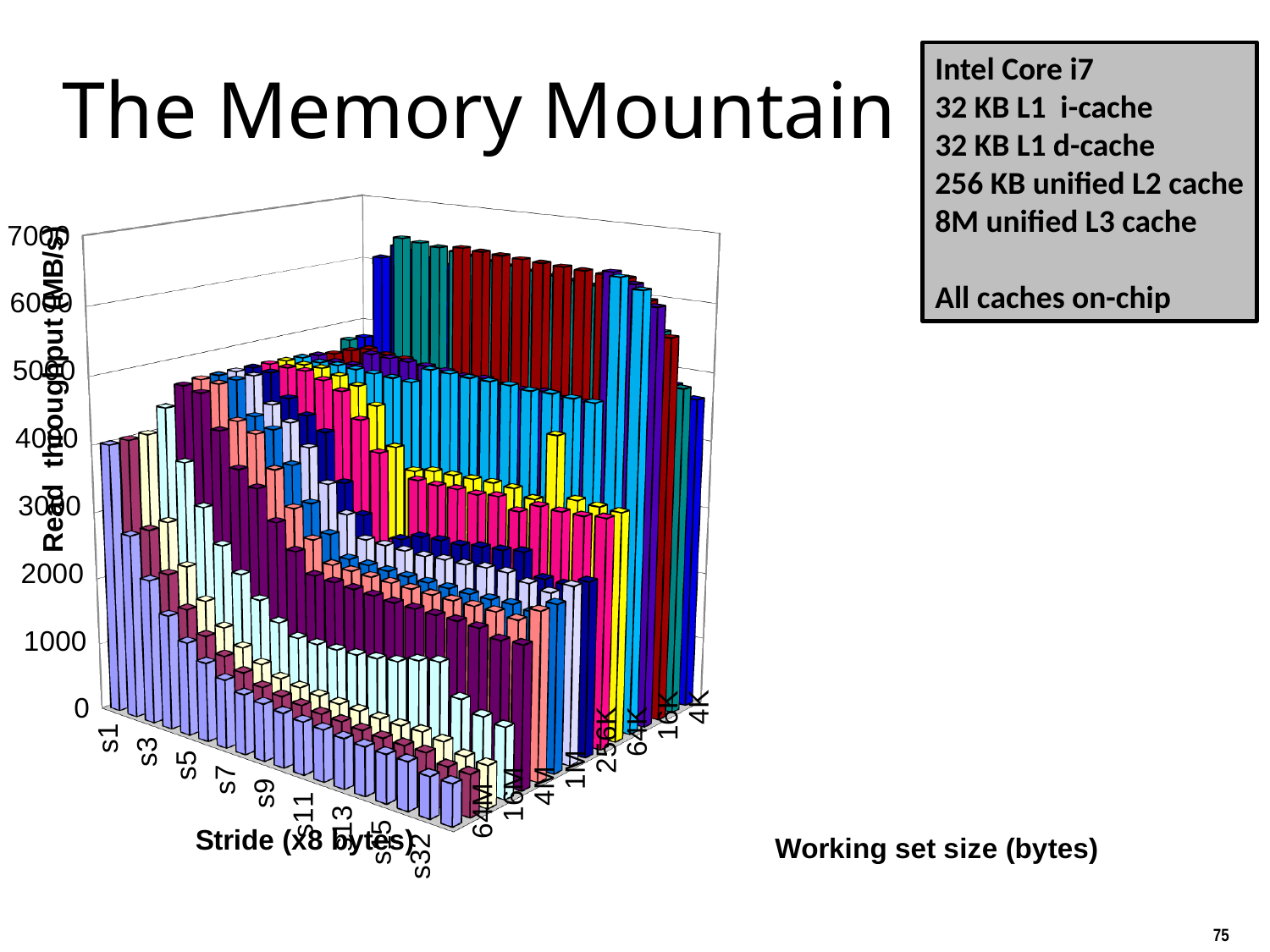
For the 64M working set size, which stride has the highest read throughput? s1 What kind of chart is shown on the slide? bar chart Is the read throughput for stride s32 at the 64M working set size greater or less than 2000 MB/s? less What is the highest value shown on the read throughput axis? 7000 Is the read throughput for stride s1 at the 4K working set size greater or less than 5000 MB/s? less How many stride labels are shown along the stride axis? 9 Which is larger: the read throughput for stride s1 at 64M or the read throughput for stride s32 at 64M? s1 at 64M What is the title of the slide's chart? The Memory Mountain Which is larger: the read throughput for stride s1 at 4K or the read throughput for stride s1 at 64M? s1 at 4K For the 64M working set size, does read throughput rise or fall as the stride increases from s1 to s32? fall What is the label of the vertical axis of the chart? Read throughput (MB/s) How many working set size labels are shown along the working set size axis? 8